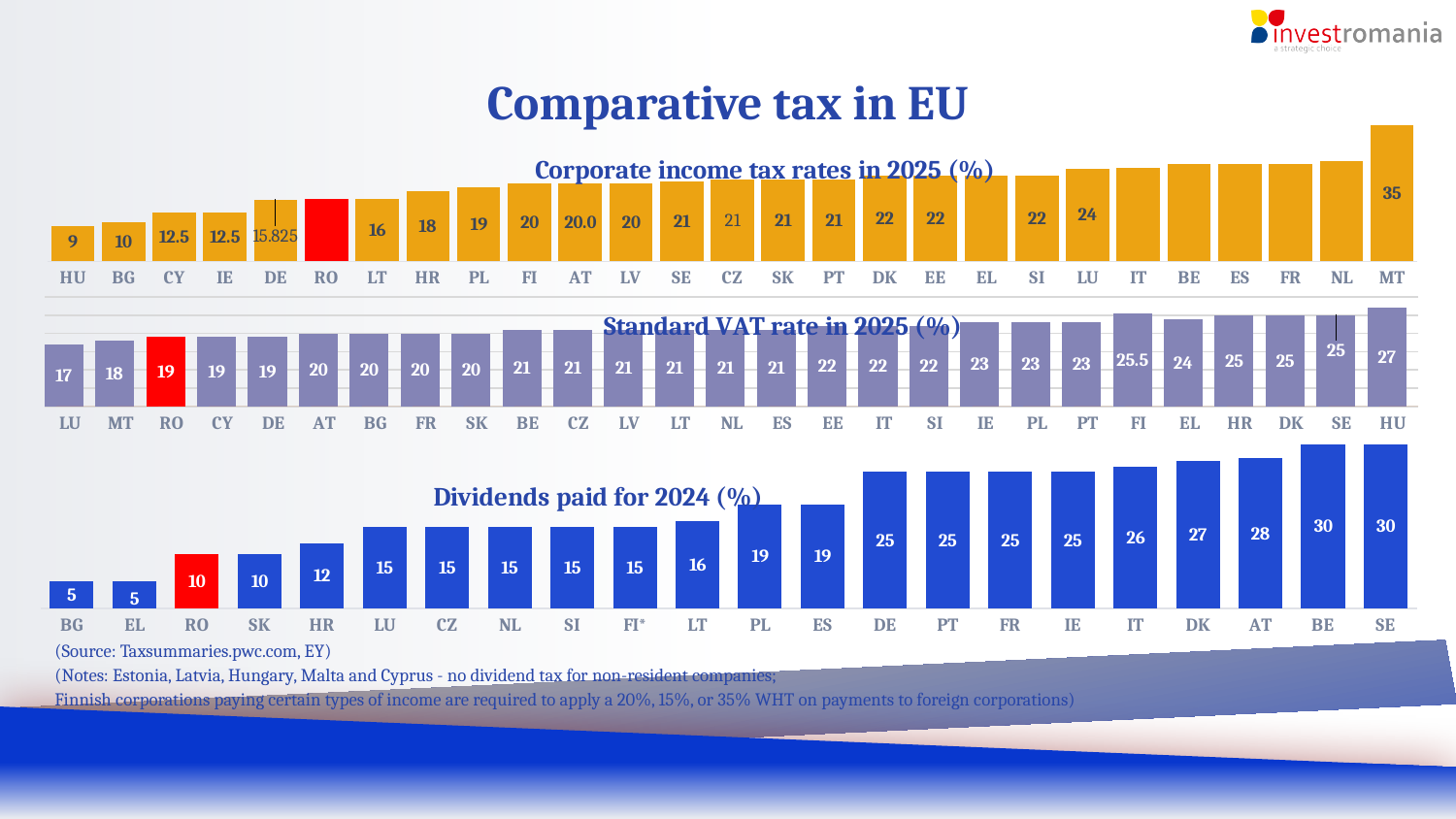
In the 'Standard VAT rate in 2025 (%)' chart, what is the value for FI? 25.5 In the 'Corporate income tax rates in 2025 (%)' chart, what is the difference between the values for MT and HU? 26 In the 'Standard VAT rate in 2025 (%)' chart, which country has the highest rate? HU What type of chart is the 'Dividends paid for 2024 (%)' chart? Bar chart In the 'Corporate income tax rates in 2025 (%)' chart, which country has the lowest rate? HU In the 'Standard VAT rate in 2025 (%)' chart, what is the difference between the values for HU and LU? 10 In the 'Corporate income tax rates in 2025 (%)' chart, what is the value for MT? 35 In the 'Standard VAT rate in 2025 (%)' chart, what colour is the bar for RO? Red In the 'Standard VAT rate in 2025 (%)' chart, which is larger, the value for IE or the value for DE? IE In the 'Corporate income tax rates in 2025 (%)' chart, what is the value for DE? 15.825 In the 'Dividends paid for 2024 (%)' chart, what is the value for AT? 28 How many countries are shown in the 'Dividends paid for 2024 (%)' chart? 22